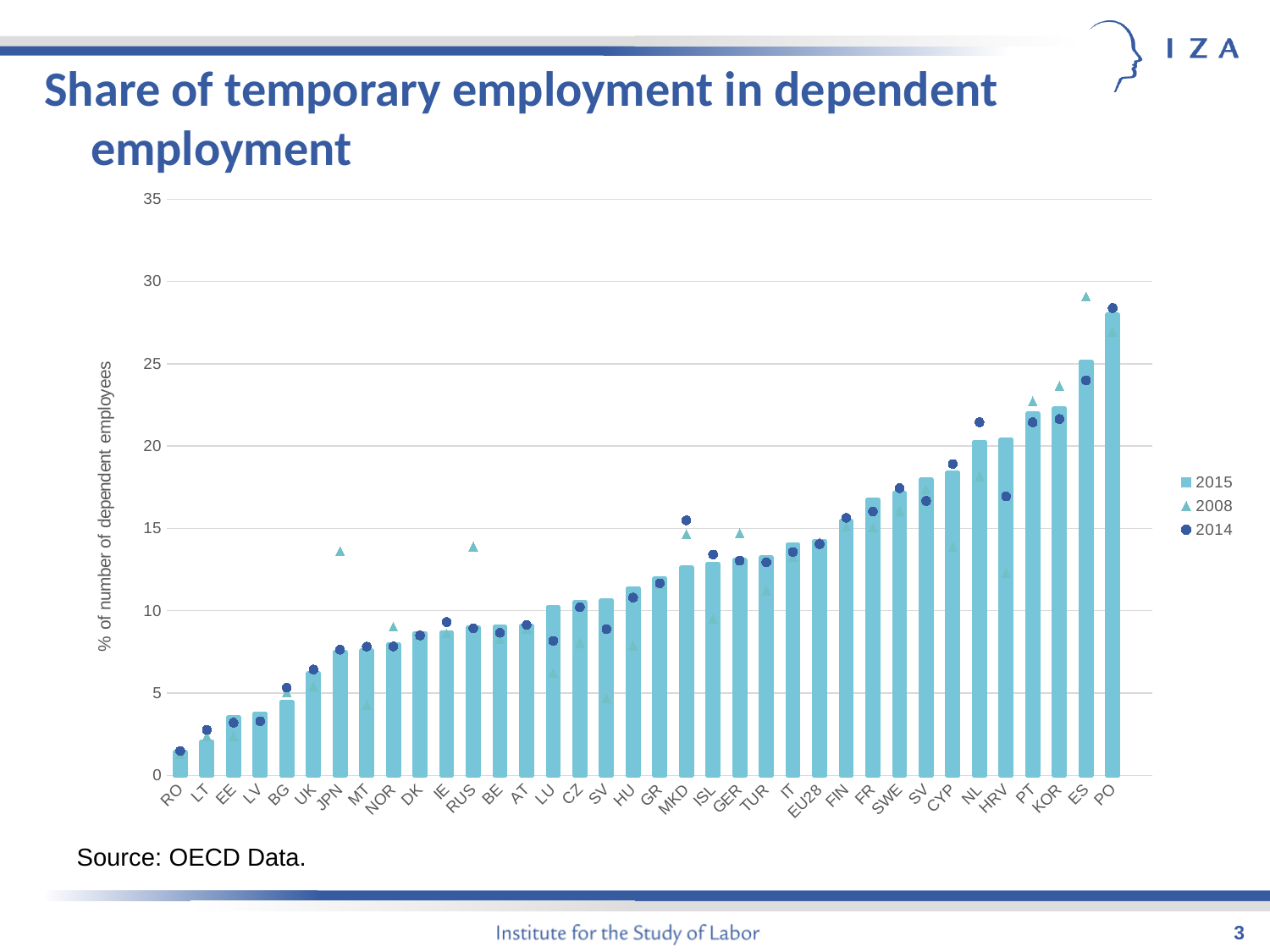
What is the label on the y axis? % of number of dependent employees What kind of chart is shown on the slide? Bar chart Is the 2015 value for LT greater or less than 5? less Is the 2015 value for KOR greater or less than 20? greater Is the 2015 value for CYP greater or less than 20? less How many series does the legend list? 3 Which category has the highest 2015 bar? PO Do the 2015 bars rise or fall from left to right along the x axis? Rise Which category has the lowest 2015 bar? RO How many countries/categories are shown on the x axis? 36